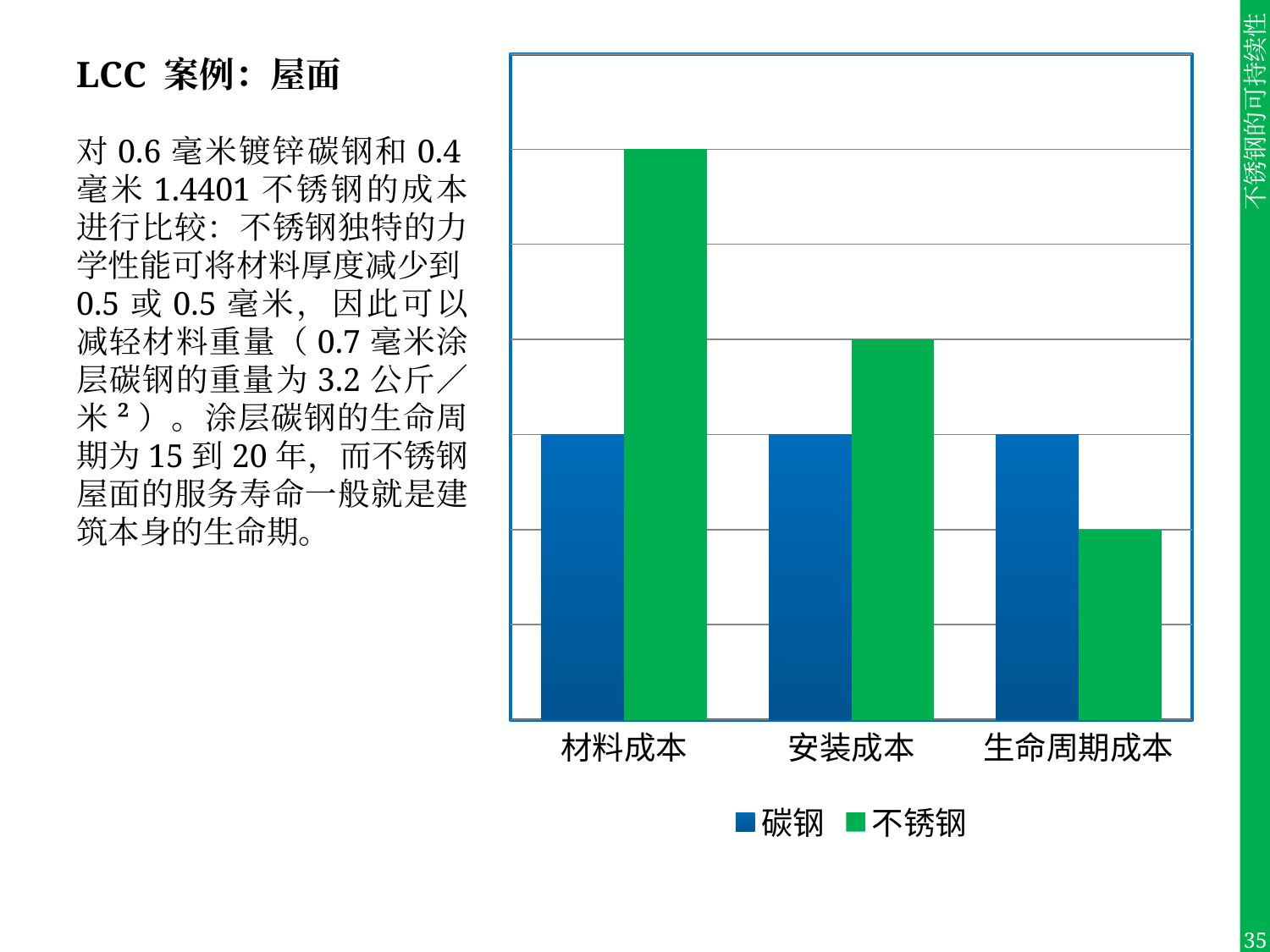
For which category is the 不锈钢 bar the lowest? 生命周期成本 For 安装成本, which is larger: 碳钢 or 不锈钢? 不锈钢 How many series does the chart's legend list? 2 For 材料成本, which is larger: 碳钢 or 不锈钢? 不锈钢 Which series are listed in the chart's legend? 碳钢 and 不锈钢 Do the 不锈钢 values rise or fall from 材料成本 to 生命周期成本? fall What kind of chart is shown on the slide? bar chart For 生命周期成本, which is larger: 碳钢 or 不锈钢? 碳钢 How many categories are shown on the x axis of the chart? 3 For which category is the 不锈钢 bar the highest? 材料成本 Which colour represents 不锈钢 in the chart? green